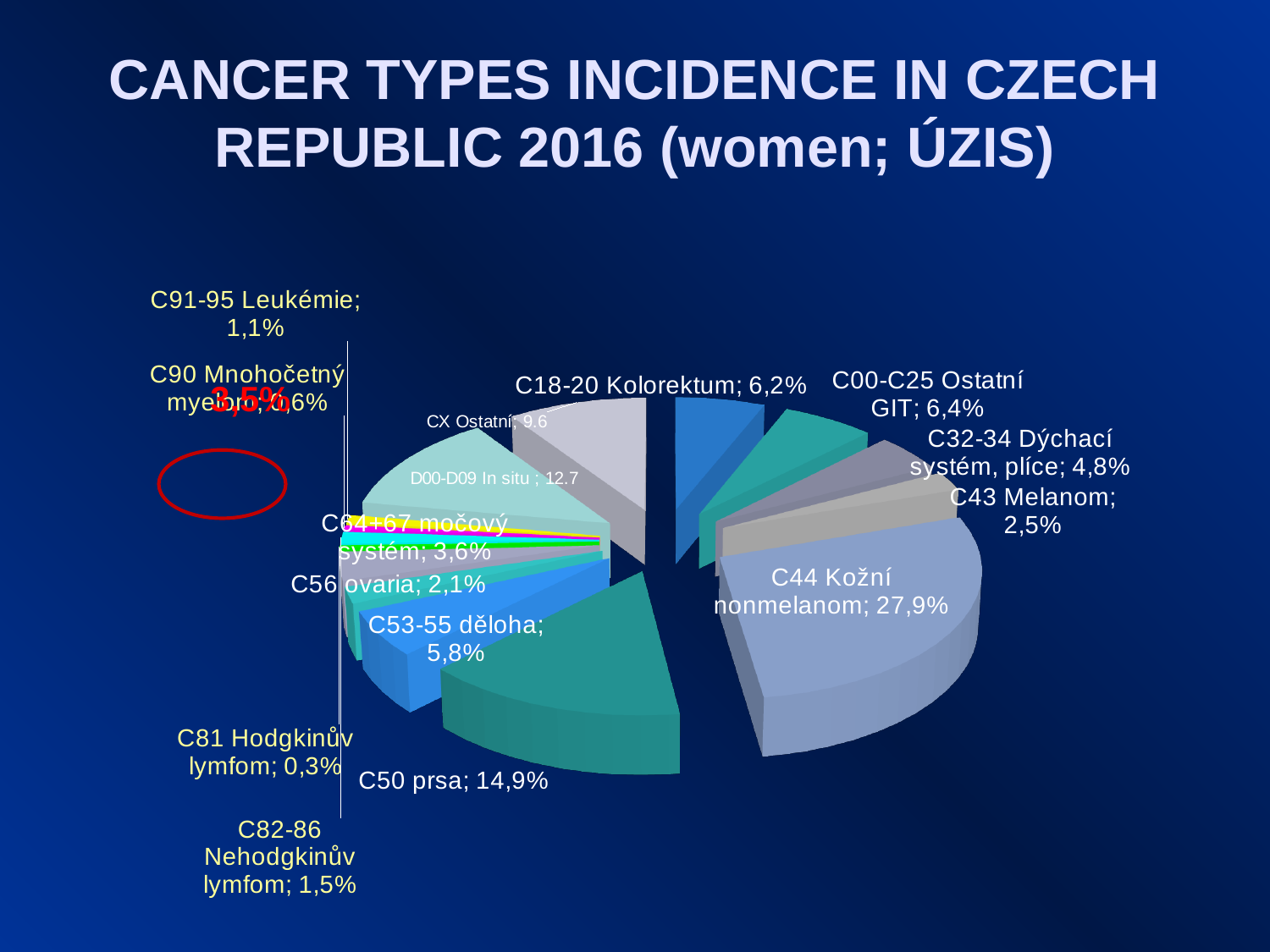
What is the title of the chart on the slide? CANCER TYPES INCIDENCE IN CZECH REPUBLIC 2016 (women; ÚZIS) Which has a larger share: C50 prsa or D00-D09 In situ? C50 prsa What percentage is shown for C43 Melanom? 2,5% Which cancer type has the largest share of the pie? C44 Kožní nonmelanom What percentage is shown for C44 Kožní nonmelanom? 27,9% What is the difference in percentage points between C44 Kožní nonmelanom and C50 prsa? 13,0% What percentage is shown for C18-20 Kolorektum? 6,2% What is the difference in percentage points between C00-C25 Ostatní GIT and C18-20 Kolorektum? 0,2% Which cancer type has the smallest share of the pie? C81 Hodgkinův lymfom What kind of chart is shown on the slide? pie chart What percentage is shown for C53-55 děloha? 5,8% What percentage is shown for C50 prsa? 14,9%